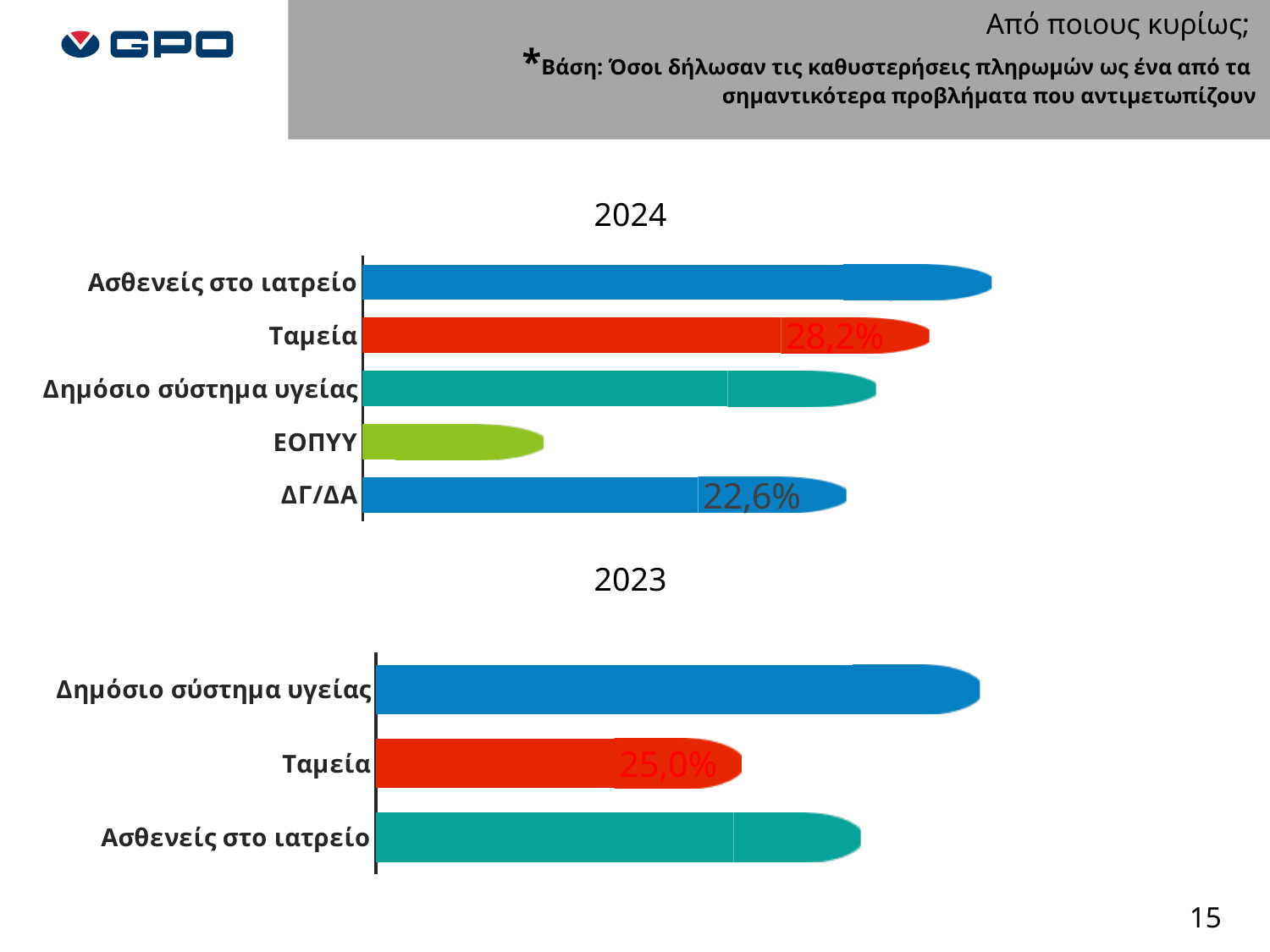
In the 2023 chart, which category has the lowest value? Ταμεία In the 2024 chart, what is the value for ΔΓ/ΔΑ? 22,6% In the 2024 chart, which is larger: Ασθενείς στο ιατρείο or Ταμεία? Ασθενείς στο ιατρείο In the 2023 chart, which category has the highest value? Δημόσιο σύστημα υγείας What kind of chart is the 2024 chart? bar chart In the 2024 chart, which category has the highest value? Ασθενείς στο ιατρείο How many categories are shown in the 2024 chart? 5 In the 2024 chart, what is the value for Ταμεία? 28,2% In the 2024 chart, what is the difference between the values for Ταμεία and ΔΓ/ΔΑ? 5,6% How many categories are shown in the 2023 chart? 3 In the 2023 chart, what is the value for Ταμεία? 25,0% In the 2024 chart, which category has the lowest value? ΕΟΠΥΥ